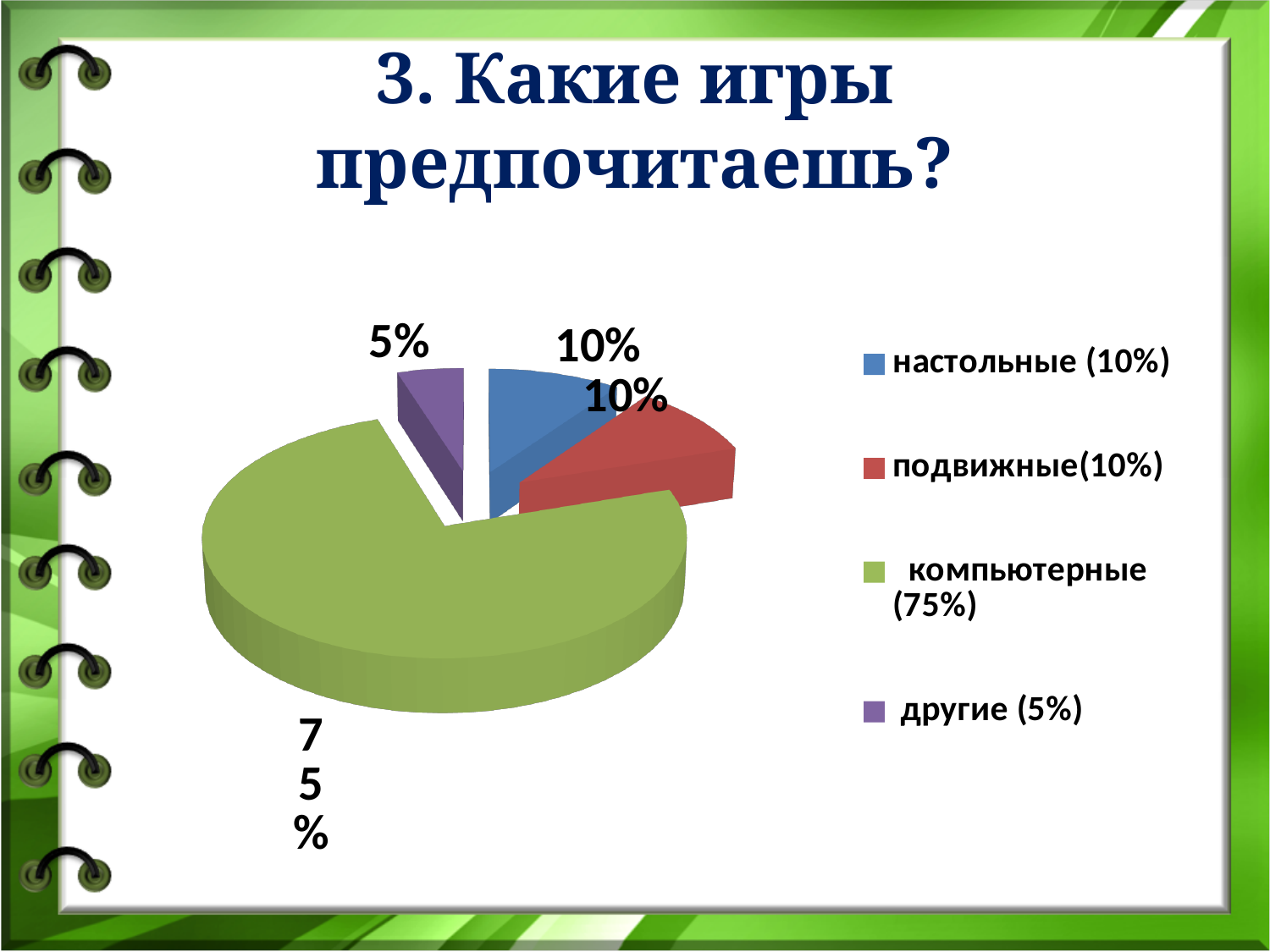
What is the value for настольные? 10% What is the value for другие? 5% What is the title of the slide containing the chart? 3. Какие игры предпочитаешь? Which category has the smallest slice of the pie? другие How many categories does the pie chart show? 4 What is the value for подвижные? 10% What is the difference between the values for компьютерные and другие? 70% Which is larger, the value for настольные or the value for другие? настольные What kind of chart is shown on the slide? pie chart What share of the pie does компьютерные have? 75% What colour is the slice for компьютерные? green Which category has the largest slice of the pie? компьютерные